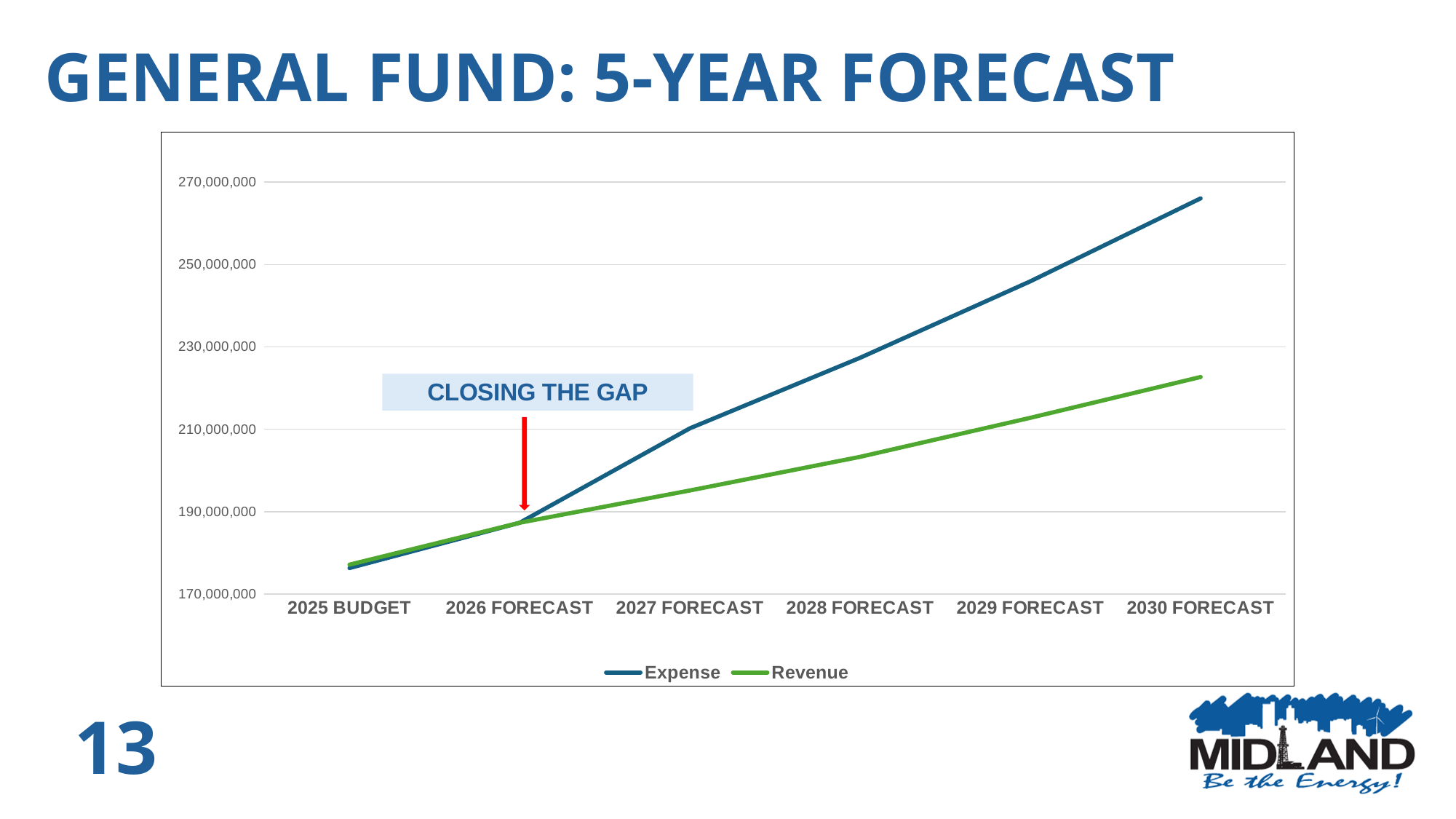
Is the Expense value for 2030 FORECAST greater or less than 250,000,000? greater Do the Expense values rise or fall from 2025 BUDGET to 2030 FORECAST? Rise Is the Revenue value for 2030 FORECAST greater or less than 210,000,000? greater Is the Revenue value for 2030 FORECAST greater or less than 230,000,000? less How many series does the legend list? 2 How many categories are shown along the x axis? 6 Which series is higher in 2030 FORECAST, Expense or Revenue? Expense What kind of chart is shown on the slide? Line chart Which category has the highest Expense value? 2030 FORECAST What text appears in the annotation box with the red arrow on the chart? CLOSING THE GAP